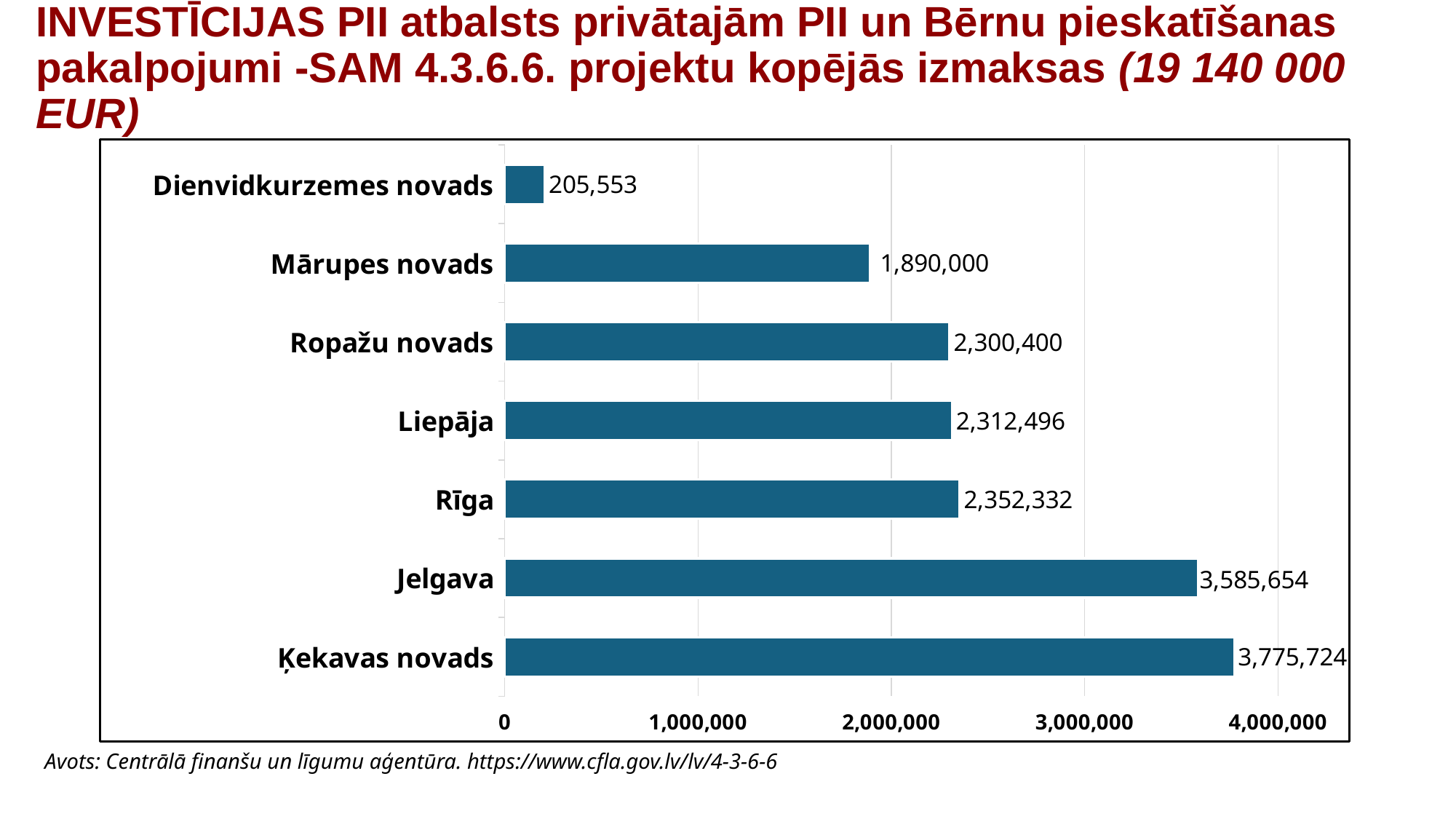
What is the value for Jelgava? 3,585,654 Is the value for Jelgava greater or less than 3,000,000? greater Which category has the lowest value? Dienvidkurzemes novads What kind of chart is shown on the slide? bar chart What is the difference between the values for Ķekavas novads and Jelgava? 190,070 What is the difference between the values for Mārupes novads and Dienvidkurzemes novads? 1,684,447 Is the value for Mārupes novads greater or less than 2,000,000? less Which category has the highest value? Ķekavas novads How many categories are shown in the chart? 7 What is the value for Dienvidkurzemes novads? 205,553 Which is larger, the value for Jelgava or the value for Rīga? Jelgava What is the value for Rīga? 2,352,332